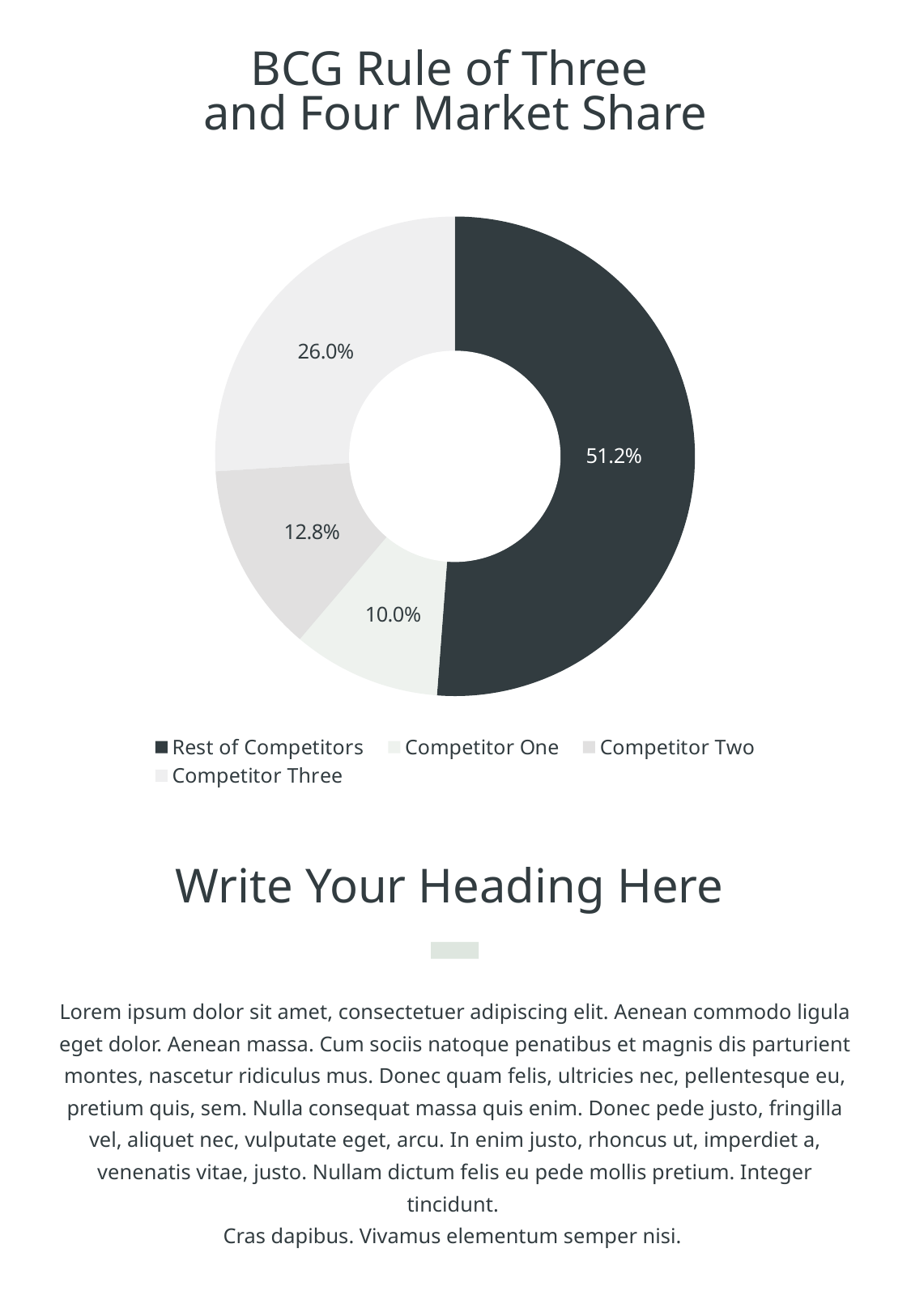
What is the market share of Competitor Two? 12.8% Which category has the largest share of the chart? Rest of Competitors What is the market share of Rest of Competitors? 51.2% Which has a larger share, Competitor Two or Competitor One? Competitor Two How many categories does the chart show? 4 What kind of chart is shown on the slide? Doughnut chart What is the difference between the shares of Competitor Three and Competitor Two? 13.2% What is the title of the chart? BCG Rule of Three and Four Market Share Which legend entry is shown in the darkest colour? Rest of Competitors What is the market share of Competitor One? 10.0% Which category has the smallest share of the chart? Competitor One What is the market share of Competitor Three? 26.0%